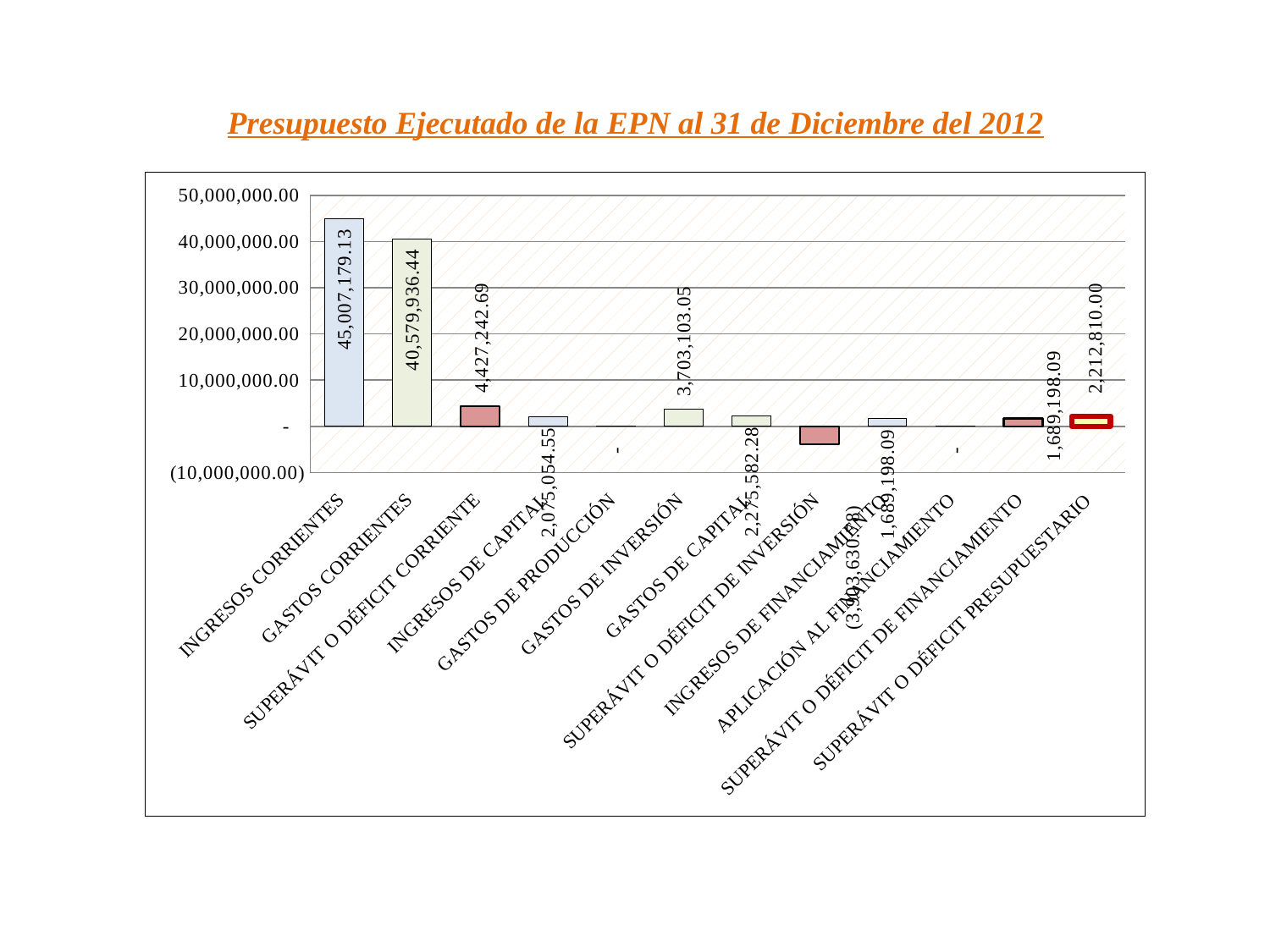
What is the value for GASTOS CORRIENTES? 40,579,936.44 Is the value for GASTOS CORRIENTES greater or less than 30,000,000.00? greater What is the value for GASTOS DE INVERSIÓN? 3,703,103.05 Which category has the highest value? INGRESOS CORRIENTES What is the difference between INGRESOS CORRIENTES and GASTOS CORRIENTES? 4,427,242.69 What type of chart is shown on the slide? Bar chart Which is larger, GASTOS DE INVERSIÓN or GASTOS DE CAPITAL? GASTOS DE INVERSIÓN What is the value for SUPERÁVIT O DÉFICIT PRESUPUESTARIO? 2,212,810.00 What is the value for INGRESOS CORRIENTES? 45,007,179.13 What is the value for INGRESOS DE FINANCIAMIENTO? 1,689,198.09 Which category has the lowest value? SUPERÁVIT O DÉFICIT DE INVERSIÓN How many categories are shown on the x axis? 12